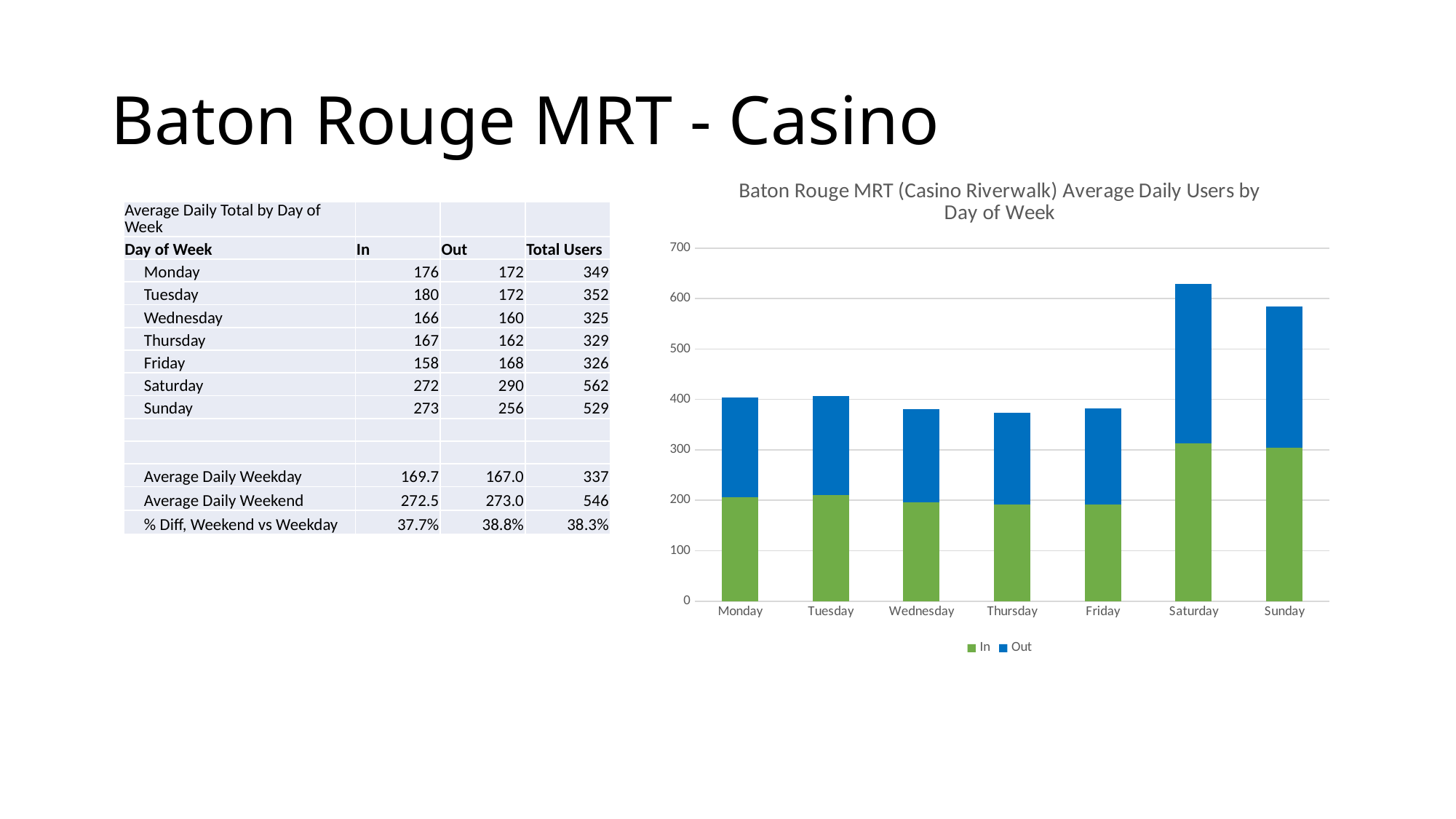
How many days of the week are plotted on the x axis of the chart? 7 What kind of chart is shown on the slide? Stacked bar chart Which has the taller total bar, Saturday or Sunday? Saturday Which colour represents the Out series in the chart? Blue Is the In (green) segment for Thursday greater or less than 200? less Is the total bar for Saturday greater or less than 600? greater Do the total bars rise or fall from Friday to Saturday? rise Which has the taller total bar, Tuesday or Friday? Tuesday Is the total bar for Wednesday greater or less than 400? less How many series does the chart's legend list? 2 Which day has the highest total bar in the chart? Saturday